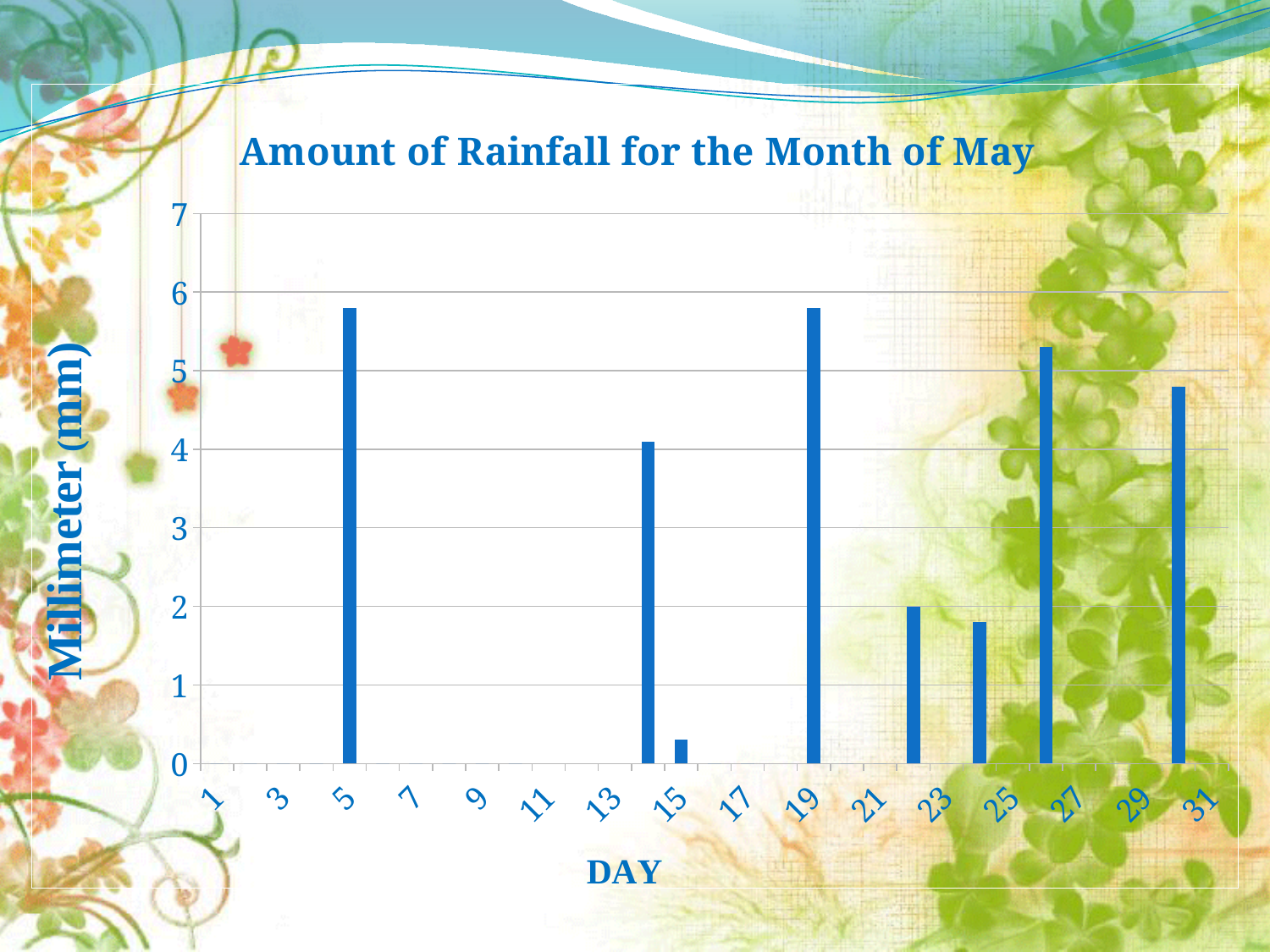
What is the title of the chart? Amount of Rainfall for the Month of May Among the days with a rainfall bar, which day has the lowest rainfall? Day 15 Is the rainfall value for day 5 greater or less than 6? less What kind of chart is shown on the slide? Bar chart Which day has more rainfall, day 5 or day 15? Day 5 Is the rainfall value for day 19 greater or less than 5? greater What is the label on the vertical axis of the chart? Millimeter (mm) How many days in the chart have a rainfall bar shown? 8 Is the rainfall value for day 5 greater or less than 5? greater Which day has more rainfall, day 19 or day 15? Day 19